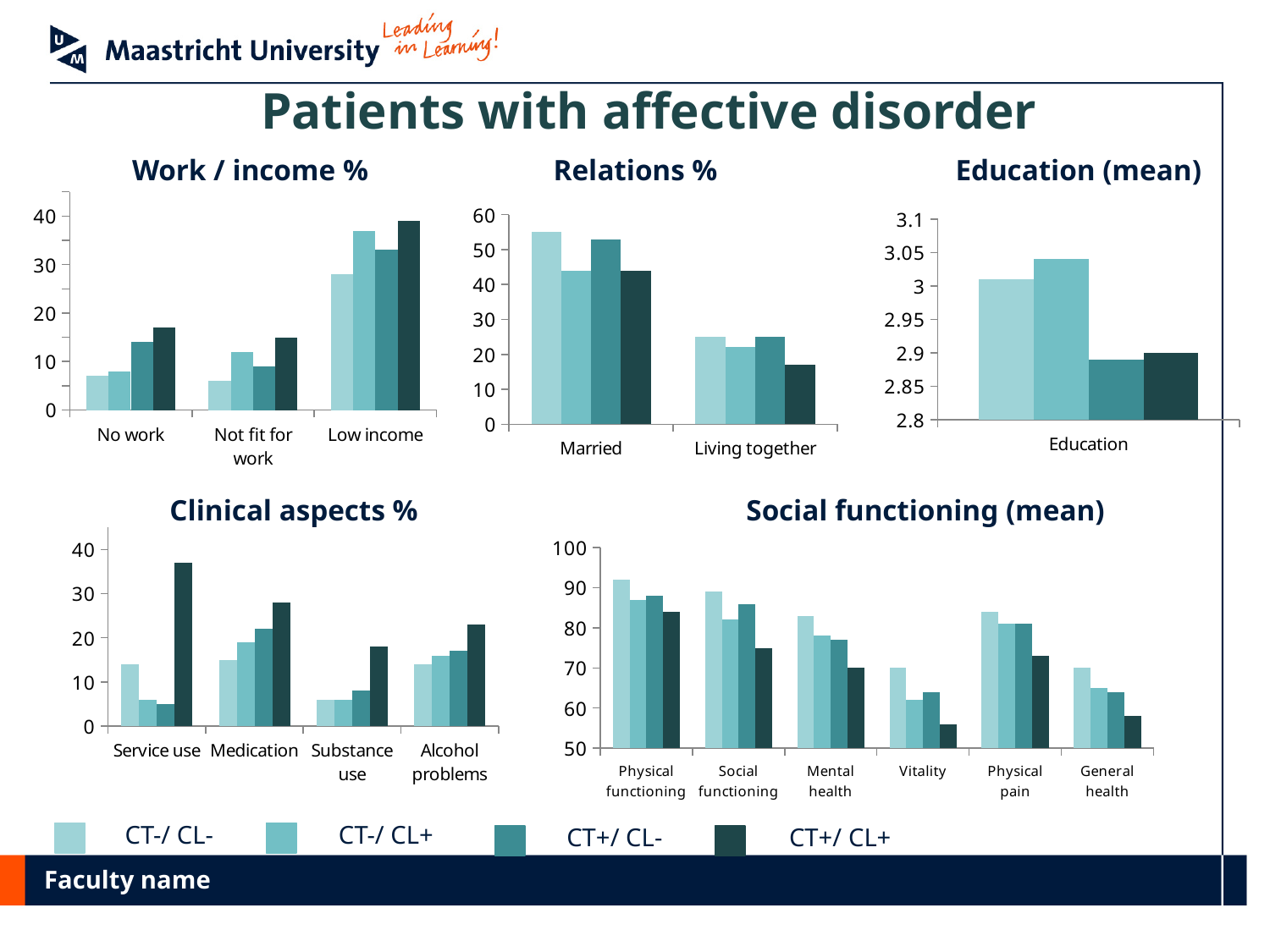
On the Social functioning (mean) chart, how many categories are shown on the x axis? 6 On the Education (mean) chart, which series has the highest value? CT-/ CL+ On the Work / income % chart, is the value for CT+/ CL+ in the Low income category greater or less than 30? greater On the Social functioning (mean) chart, is the value for CT+/ CL+ in the Vitality category greater or less than 60? less What kind of chart is the Social functioning (mean) chart? bar chart On the Relations % chart, which category has the higher value for CT-/ CL-, Married or Living together? Married On the Clinical aspects % chart, which category has the highest value for CT+/ CL+? Service use On the Clinical aspects % chart, how many categories are shown on the x axis? 4 How many series does the shared legend at the bottom of the slide list? 4 On the Relations % chart, is the value for CT+/ CL+ in the Living together category greater or less than 20? less On the Work / income % chart, how many categories are shown on the x axis? 3